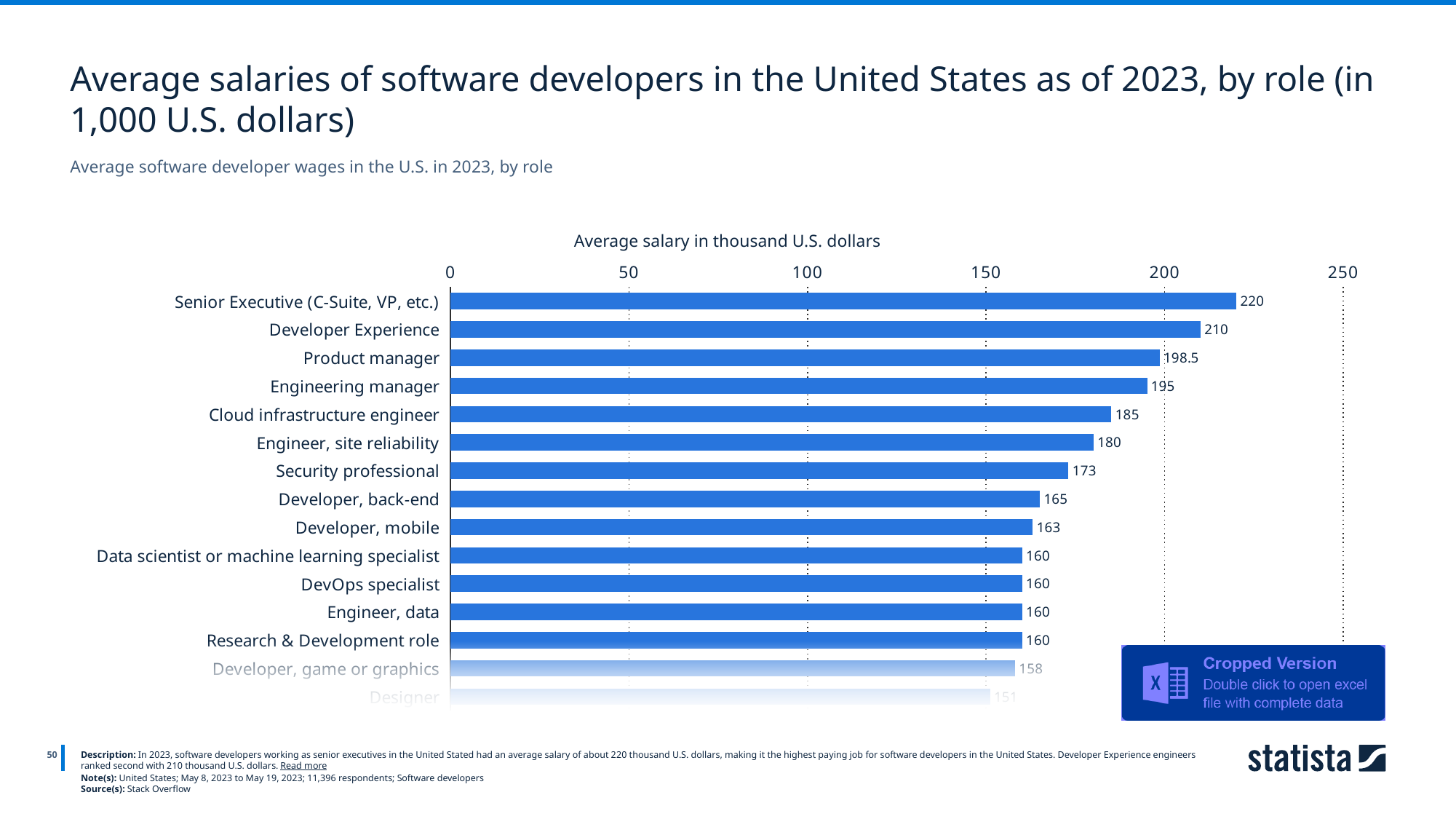
What is the average salary for Security professional? 173 What is the average salary for Product manager? 198.5 Which has a higher average salary, Developer, back-end or DevOps specialist? Developer, back-end What kind of chart is shown on the slide? Bar chart What is the difference between the average salary for Engineering manager and Engineer, site reliability? 15 What is the average salary for Cloud infrastructure engineer? 185 What is the title of the horizontal axis? Average salary in thousand U.S. dollars Which role has the highest average salary? Senior Executive (C-Suite, VP, etc.) What is the average salary for Senior Executive (C-Suite, VP, etc.)? 220 What is the difference between the average salary for Senior Executive (C-Suite, VP, etc.) and Developer Experience? 10 What is the average salary for Developer, mobile? 163 Is the value for Engineer, site reliability greater or less than 150? greater